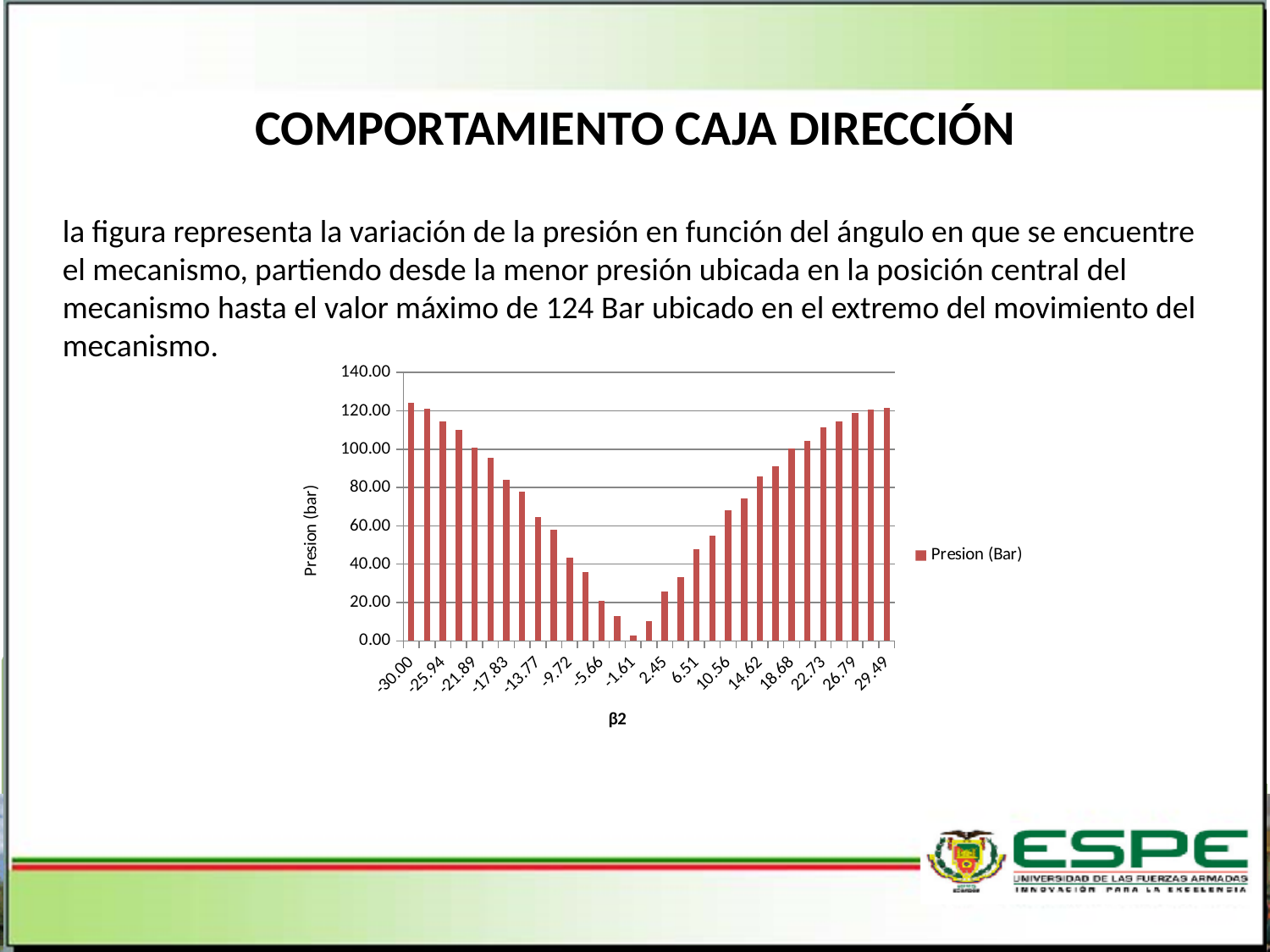
Is the value for -30.00 greater or less than 100? greater What kind of chart is shown on the slide? bar chart Which is larger, the value for -30.00 or the value for -1.61? -30.00 What is the title of the vertical axis of the chart? Presion (bar) Is the value for 10.56 greater or less than 40? greater Is the value for -13.77 greater or less than 40? greater Which labelled category has the lowest pressure value? -1.61 Do the values rise or fall along the x axis from -30.00 to -1.61? fall What is the name of the series shown in the chart legend? Presion (Bar) How many series does the chart legend list? 1